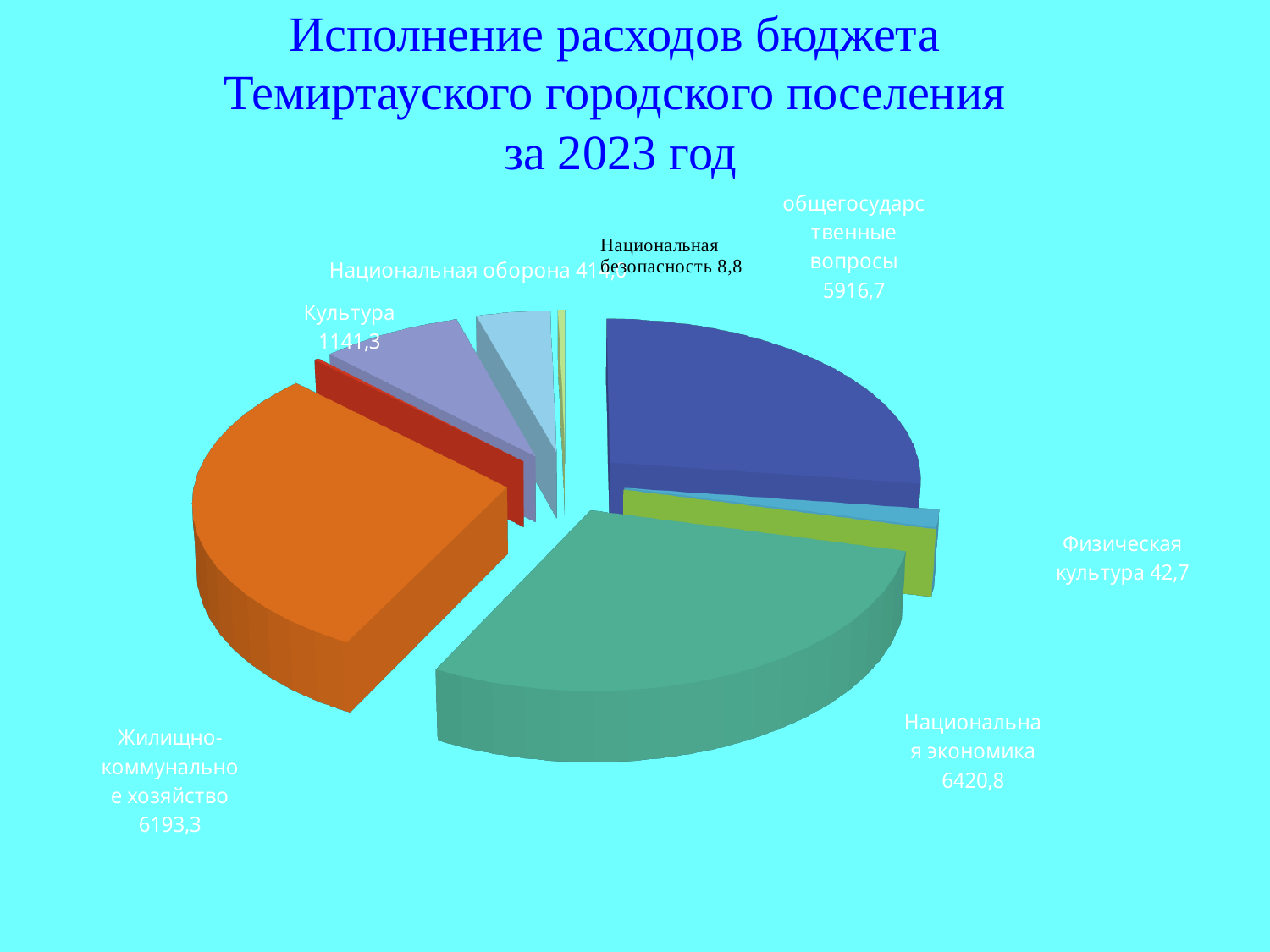
Which is larger, общегосударственные вопросы or Жилищно-коммунальное хозяйство? Жилищно-коммунальное хозяйство What is the value for Национальная экономика? 6420,8 Which labelled category has the highest value? Национальная экономика What is the difference between Национальная экономика and Жилищно-коммунальное хозяйство? 227,5 What is the value for общегосударственные вопросы? 5916,7 What type of chart is shown on the slide? pie chart What is the value for Физическая культура? 42,7 What is the value for Национальная безопасность? 8,8 Which labelled category has the lowest value? Национальная безопасность What is the value for Культура? 1141,3 Which year does the chart title say the budget expenditure execution refers to? 2023 What is the value for Жилищно-коммунальное хозяйство? 6193,3